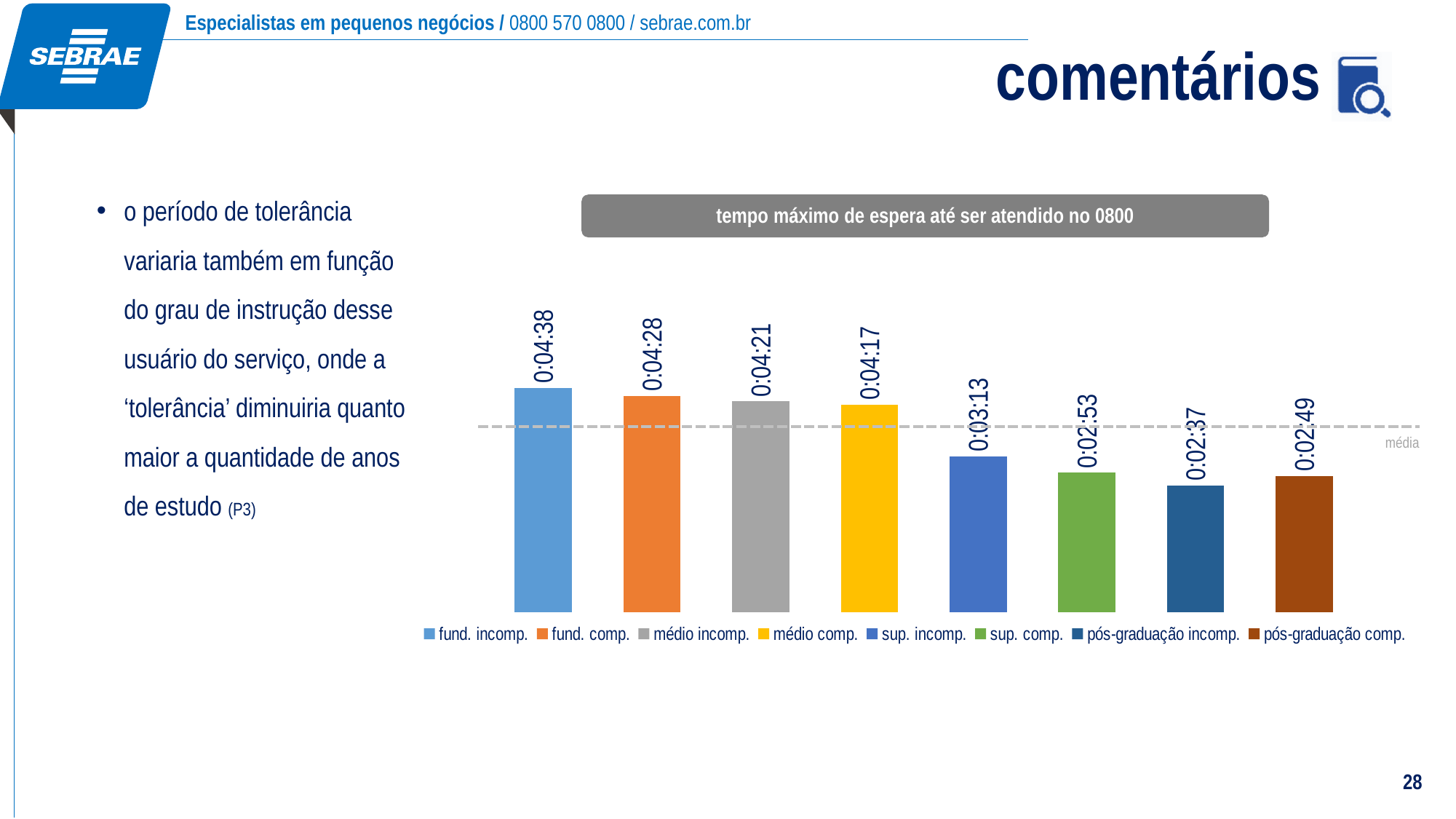
Which category has the highest maximum waiting time? fund. incomp. What is the difference between the values for fund. incomp. and pós-graduação incomp.? 0:02:01 What kind of chart is shown on the slide? bar chart What is the value shown for sup. incomp.? 0:03:13 What is the value shown for pós-graduação comp.? 0:02:49 What is the title of the chart? tempo máximo de espera até ser atendido no 0800 Which category has the lowest maximum waiting time? pós-graduação incomp. What is the difference between the values for fund. incomp. and fund. comp.? 0:00:10 Which is larger, the value for sup. comp. or the value for pós-graduação comp.? sup. comp. What is the value shown for fund. incomp.? 0:04:38 How many bars are plotted in the chart? 8 How many entries does the legend list? 8